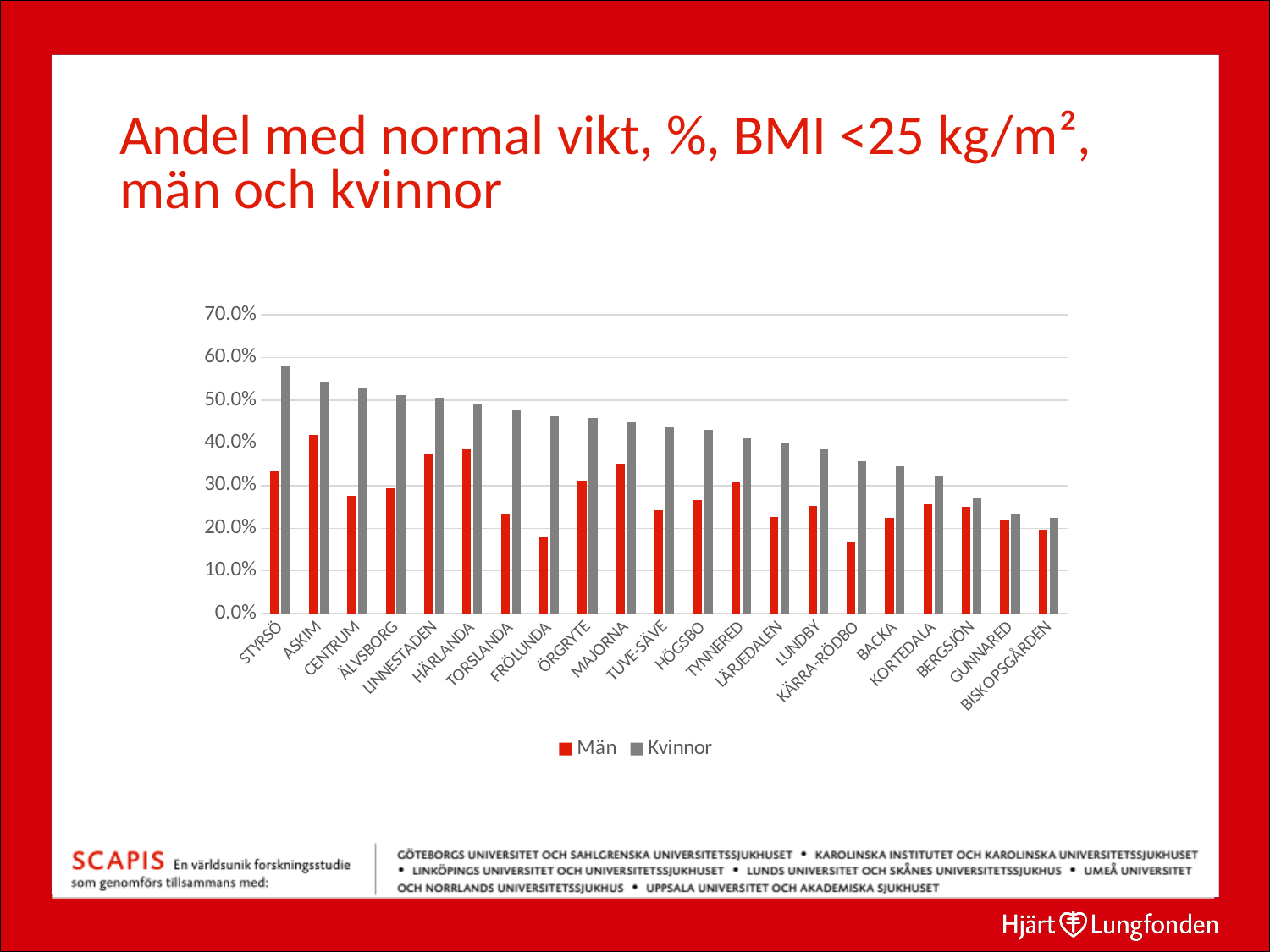
What kind of chart is shown on the slide? bar chart How many categories (areas) are shown on the x axis? 21 Which category has the highest value for Män? Askim Is the Män value for Kärra-Rödbo greater or less than 20%? less Is the Män value for Askim greater or less than 40%? greater Do the Kvinnor values generally rise or fall from left to right along the x axis? fall Which colour represents the Män series? red How many series does the legend list? 2 Is the Män value for Frölunda greater or less than 20%? less For Styrsö, which is larger, the value for Män or for Kvinnor? Kvinnor Which category has the highest value for Kvinnor? Styrsö